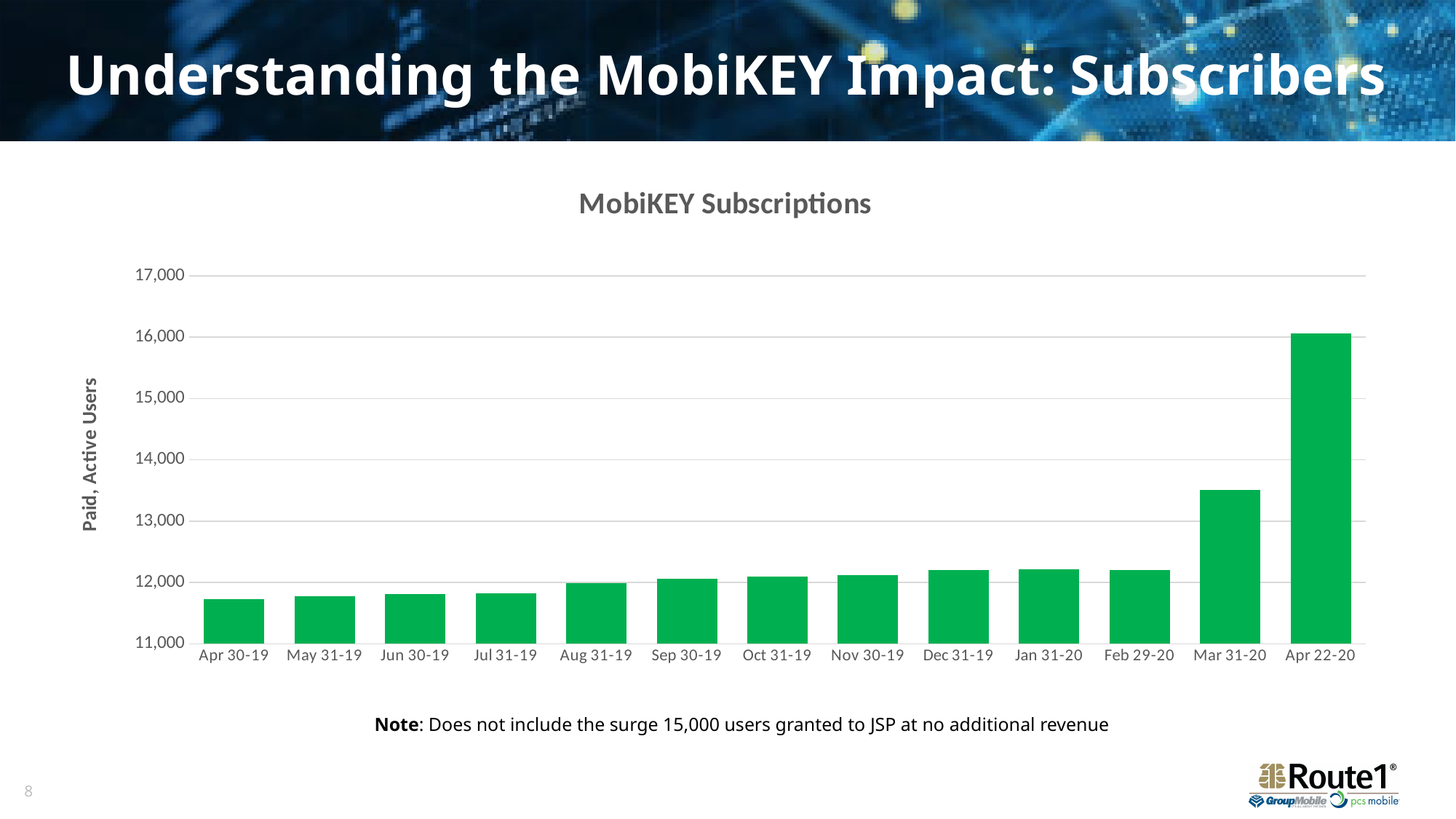
What is the label on the vertical axis of the chart? Paid, Active Users Is the value for Apr 30-19 greater or less than 12,000? less Is the value for Apr 22-20 greater or less than 15,000? greater Do the values generally rise or fall from Apr 30-19 to Apr 22-20? rise Is the value for Mar 31-20 greater or less than 13,000? greater Which is larger, the value for Feb 29-20 or the value for Mar 31-20? Mar 31-20 Which date has the highest number of paid, active users? Apr 22-20 What is the title of the chart? MobiKEY Subscriptions What kind of chart is shown on the slide? bar chart How many dates (bars) are shown on the x axis of the chart? 13